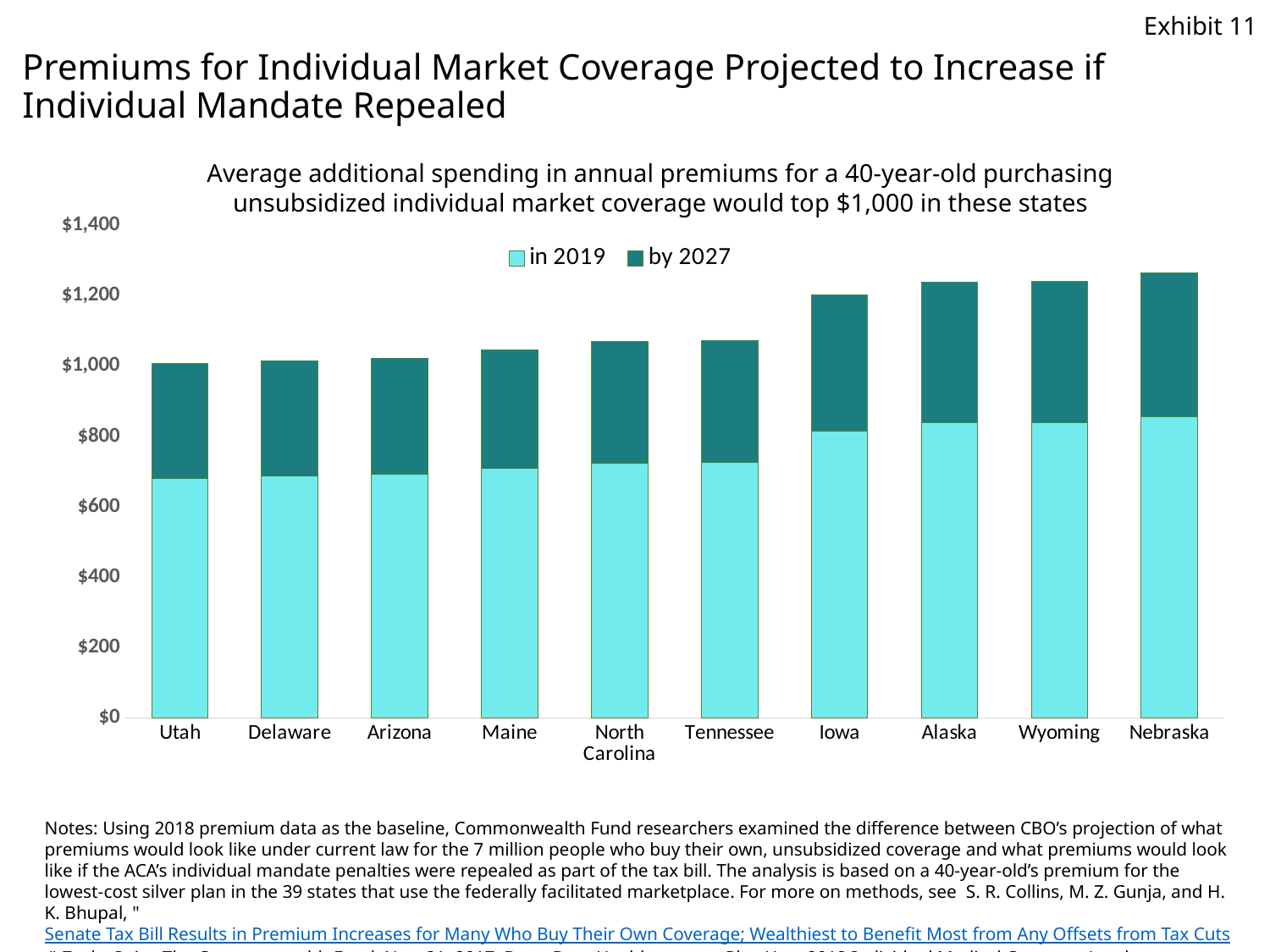
How many states are shown on the x axis of the chart? 10 Which has the larger 'in 2019' value, Iowa or Utah? Iowa Is the total bar for Tennessee greater or less than $1,200? less Is the 'in 2019' value for Nebraska greater or less than $800? greater How many series does the chart's legend list? 2 Is the total bar for Alaska greater or less than $1,200? greater Which state has the tallest total bar in the chart? Nebraska What are the two series named in the chart's legend? in 2019 and by 2027 What kind of chart is shown on the slide? Stacked bar chart Do the total bar heights rise or fall moving from Utah on the left to Nebraska on the right? rise